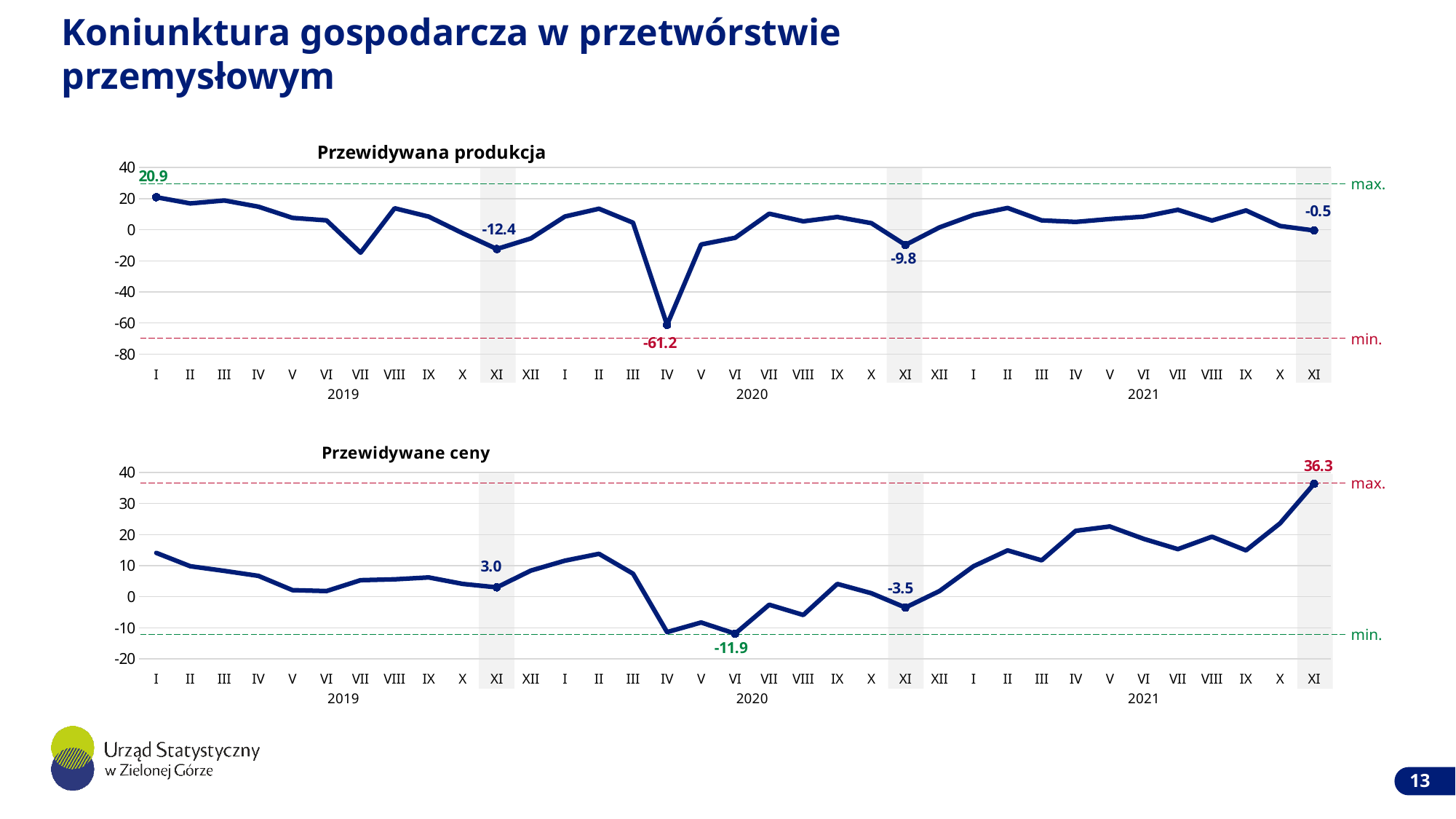
In the 'Przewidywane ceny' chart, is the value for V 2021 greater or less than 20? greater In the 'Przewidywane ceny' chart, which is larger: the value for XI 2019 or the value for XI 2020? XI 2019 In the 'Przewidywane ceny' chart, which month has the highest value? XI 2021 In the 'Przewidywane ceny' chart, what is the value for XI 2021? 36.3 In the 'Przewidywana produkcja' chart, which month has the lowest value? IV 2020 In the 'Przewidywane ceny' chart, what is the value for VI 2020? -11.9 In the 'Przewidywana produkcja' chart, what is the value for XI 2021? -0.5 In the 'Przewidywane ceny' chart, do the values rise or fall from VI 2021 to XI 2021? rise In the 'Przewidywana produkcja' chart, what is the value for I 2019? 20.9 In the 'Przewidywana produkcja' chart, what is the difference between the values for XI 2019 and XI 2020? 2.6 In the 'Przewidywana produkcja' chart, what is the value for IV 2020? -61.2 What kind of chart is 'Przewidywana produkcja'? line chart